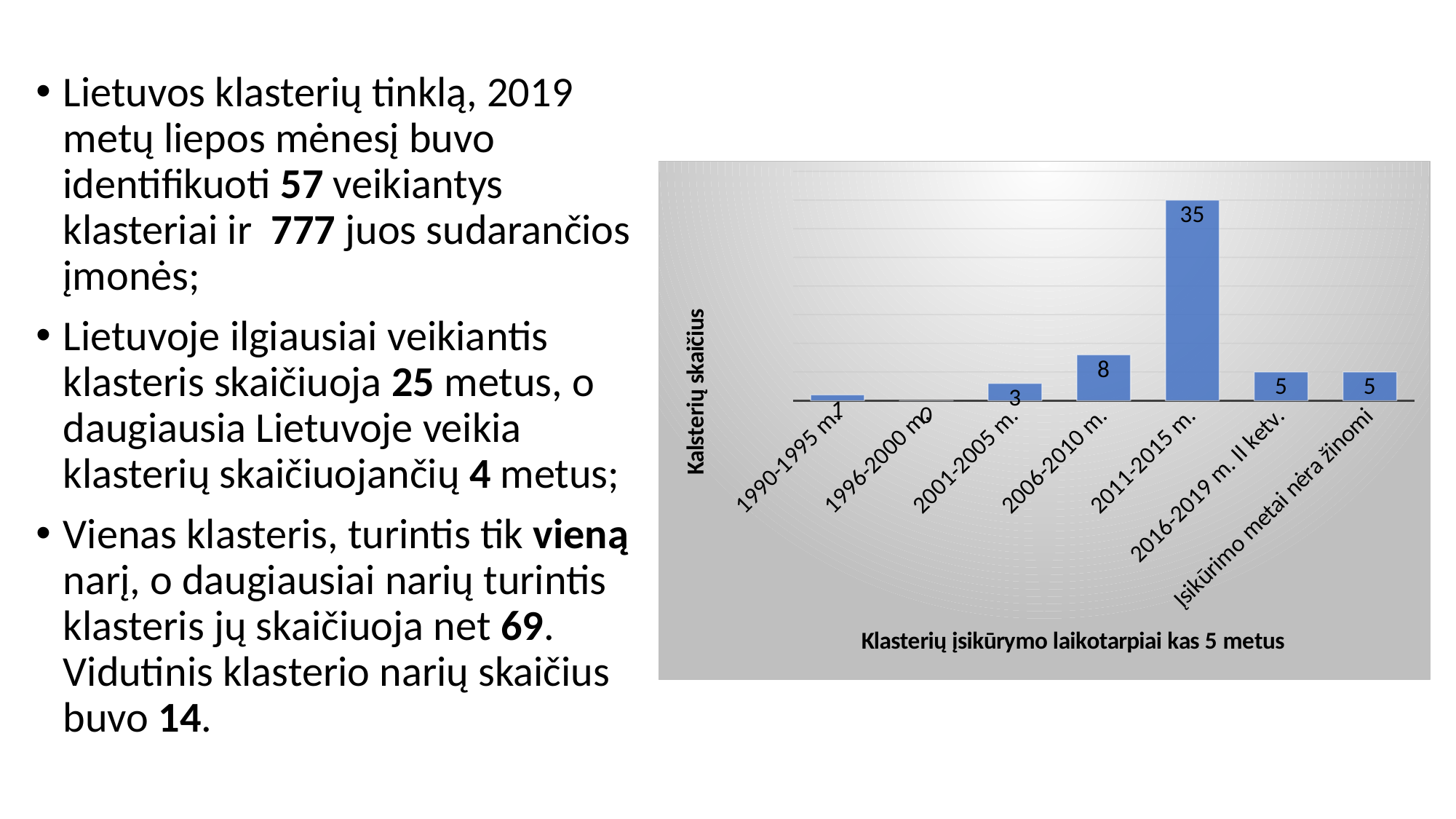
What is the difference between the values for 2011-2015 m. and 2006-2010 m.? 27 What type of chart is shown on the slide? bar chart What is the value for 2001-2005 m. in the chart? 3 Which category has the lowest value in the chart? 1996-2000 m. What is the value for 2016-2019 m. II ketv. in the chart? 5 What is the title of the x axis of the chart? Klasterių įsikūrymo laikotarpiai kas 5 metus Which is larger: the value for 2006-2010 m. or the value for 2016-2019 m. II ketv.? 2006-2010 m. What is the label of the vertical axis of the chart? Kalsterių skaičius How many categories (time periods) are shown on the x axis of the chart? 7 What is the value for 2011-2015 m. in the chart? 35 Which category has the highest value in the chart? 2011-2015 m. What is the value for 2006-2010 m. in the chart? 8